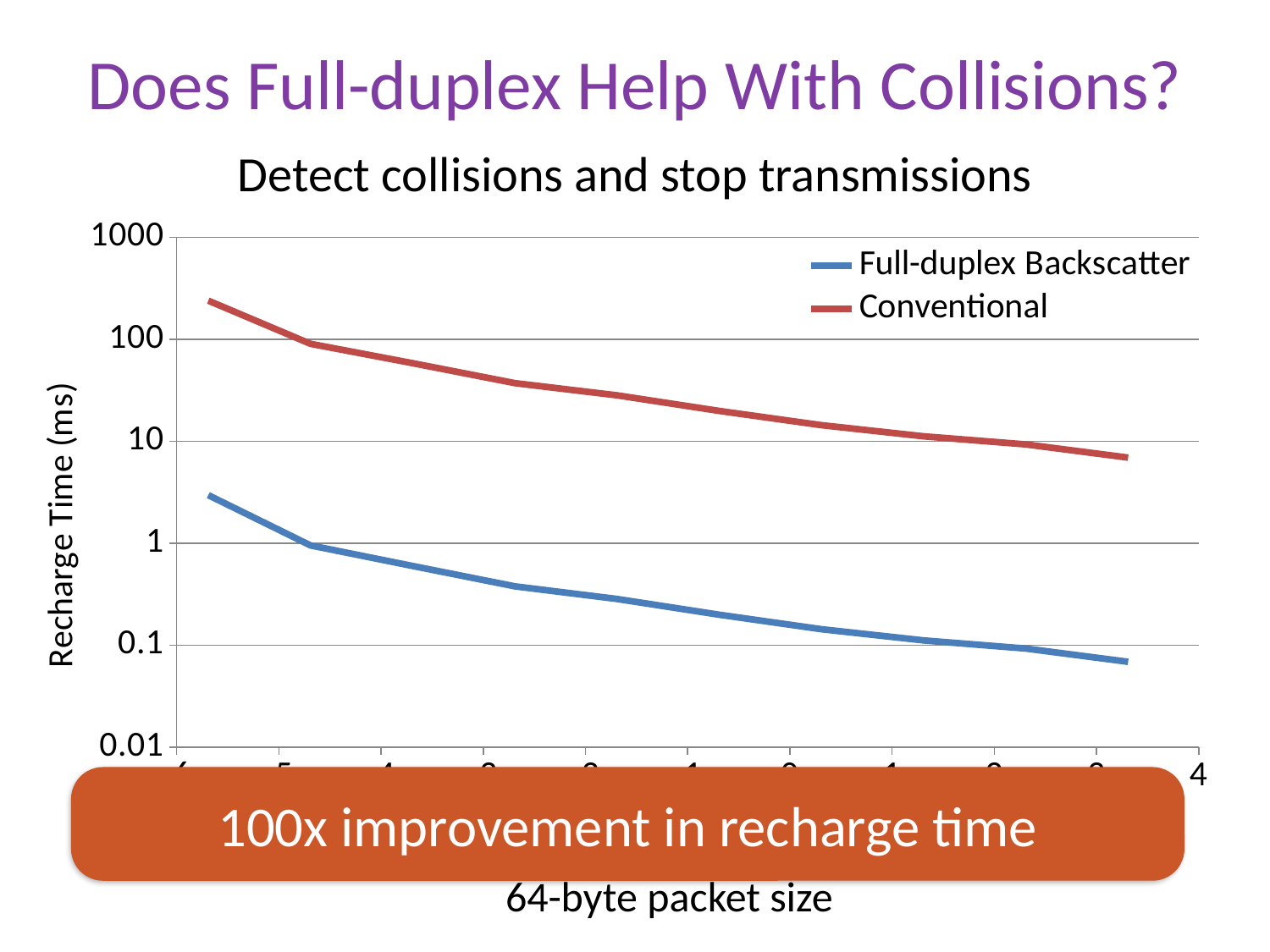
Which series has the higher recharge time across the chart, Full-duplex Backscatter or Conventional? Conventional Is the rightmost value for Full-duplex Backscatter greater or less than 0.1? less Which series is the lower line on the chart? Full-duplex Backscatter Does the recharge time for Full-duplex Backscatter rise or fall from left to right along the x axis? fall What is the title of the chart? Detect collisions and stop transmissions How many series does the legend list? 2 What kind of chart is shown on the slide? line chart Is the leftmost value for Full-duplex Backscatter greater or less than 1? greater Is the leftmost value for Conventional greater or less than 100? greater Does the recharge time for Conventional rise or fall from left to right along the x axis? fall What is the label of the vertical axis? Recharge Time (ms)